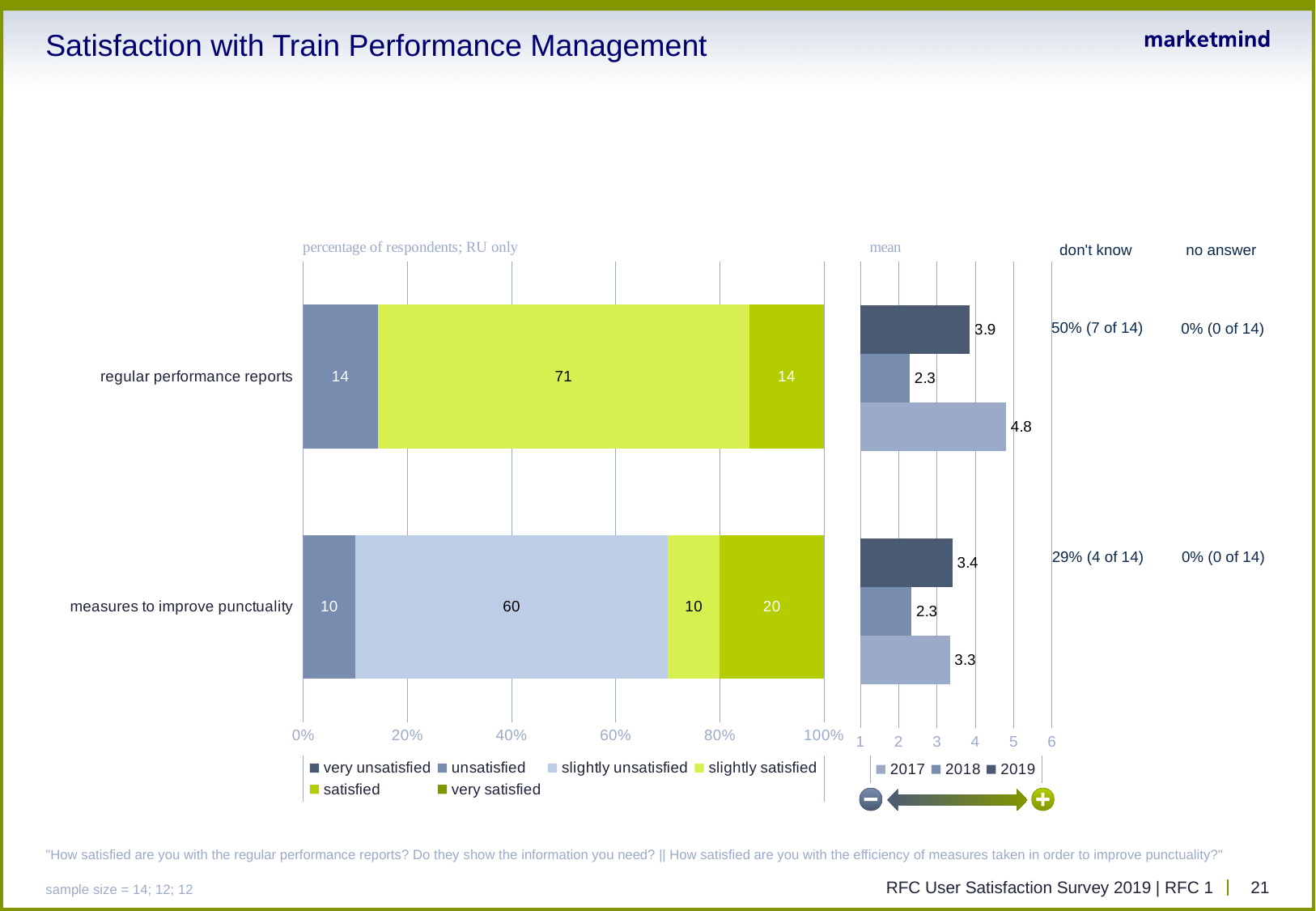
In the stacked percentage chart, what percentage of respondents were slightly unsatisfied with measures to improve punctuality? 60 In the mean chart, what is the 2017 mean for measures to improve punctuality? 3.3 How many series does the legend of the mean chart list? 3 In the mean chart, what is the 2019 mean for regular performance reports? 3.9 How many categories are shown in the stacked percentage chart? 2 In the mean chart, what is the difference between the 2017 and 2018 means for regular performance reports? 2.5 In the mean chart, which year has the lowest mean for measures to improve punctuality? 2018 What kind of chart is the percentage of respondents chart? stacked bar chart In the mean chart, which year has the highest mean for regular performance reports? 2017 In the mean chart, which has the higher 2019 mean: regular performance reports or measures to improve punctuality? regular performance reports How many series does the legend of the stacked percentage chart list? 6 In the stacked percentage chart, what percentage of respondents were slightly satisfied with regular performance reports? 71